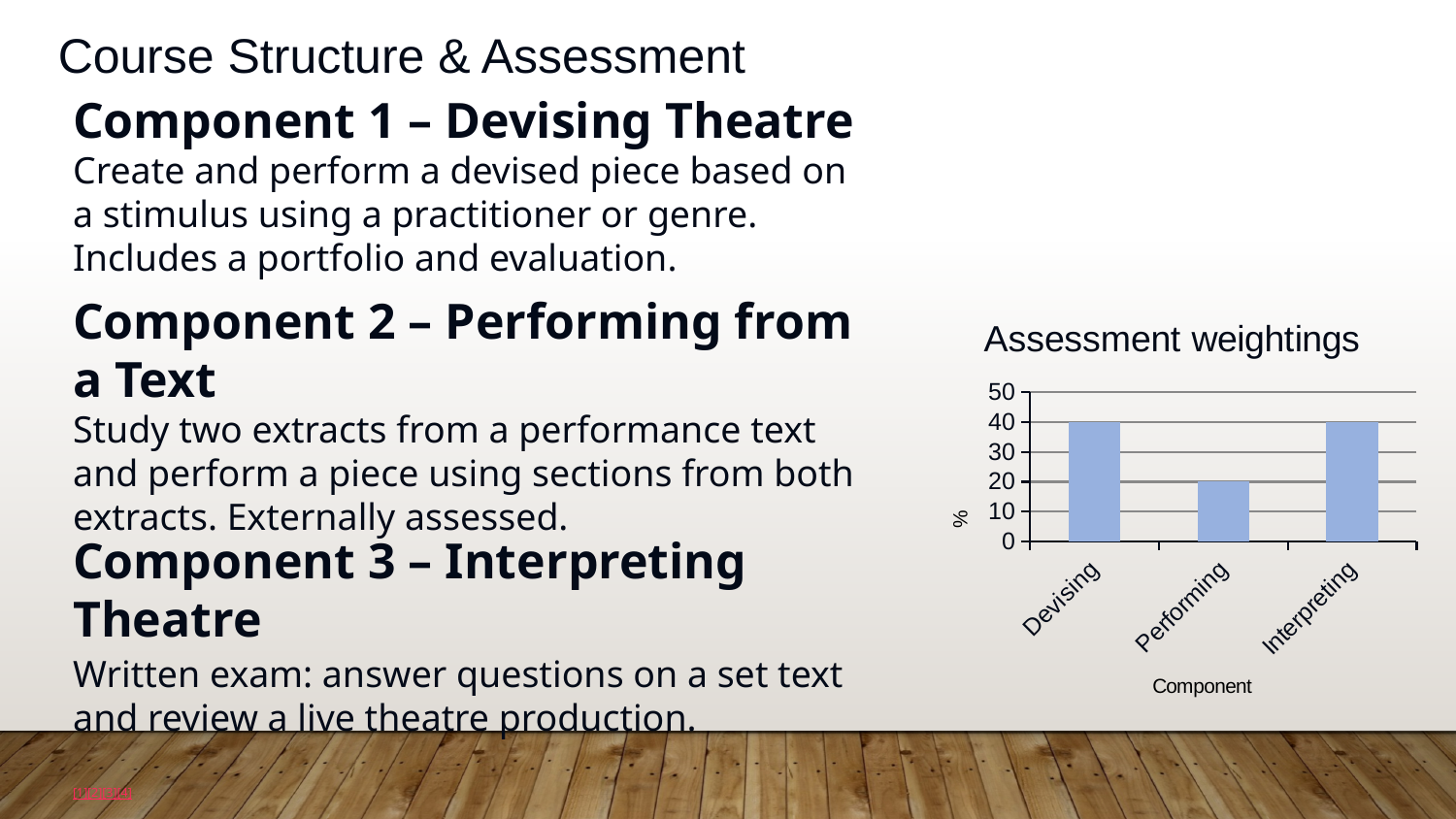
What is the value for Devising in the Assessment weightings chart? 40 What is the value for Interpreting in the Assessment weightings chart? 40 What kind of chart is shown on the slide? bar chart What is the title of the chart? Assessment weightings Which component has the lowest weighting in the chart? Performing Is the value for Performing greater or less than 30? less How many components are shown on the x axis of the chart? 3 What is the label on the x axis of the chart? Component What is the value for Performing in the Assessment weightings chart? 20 Is the value for Interpreting greater or less than 30? greater Which is larger, the value for Devising or the value for Performing? Devising What is the difference between the values for Devising and Performing? 20